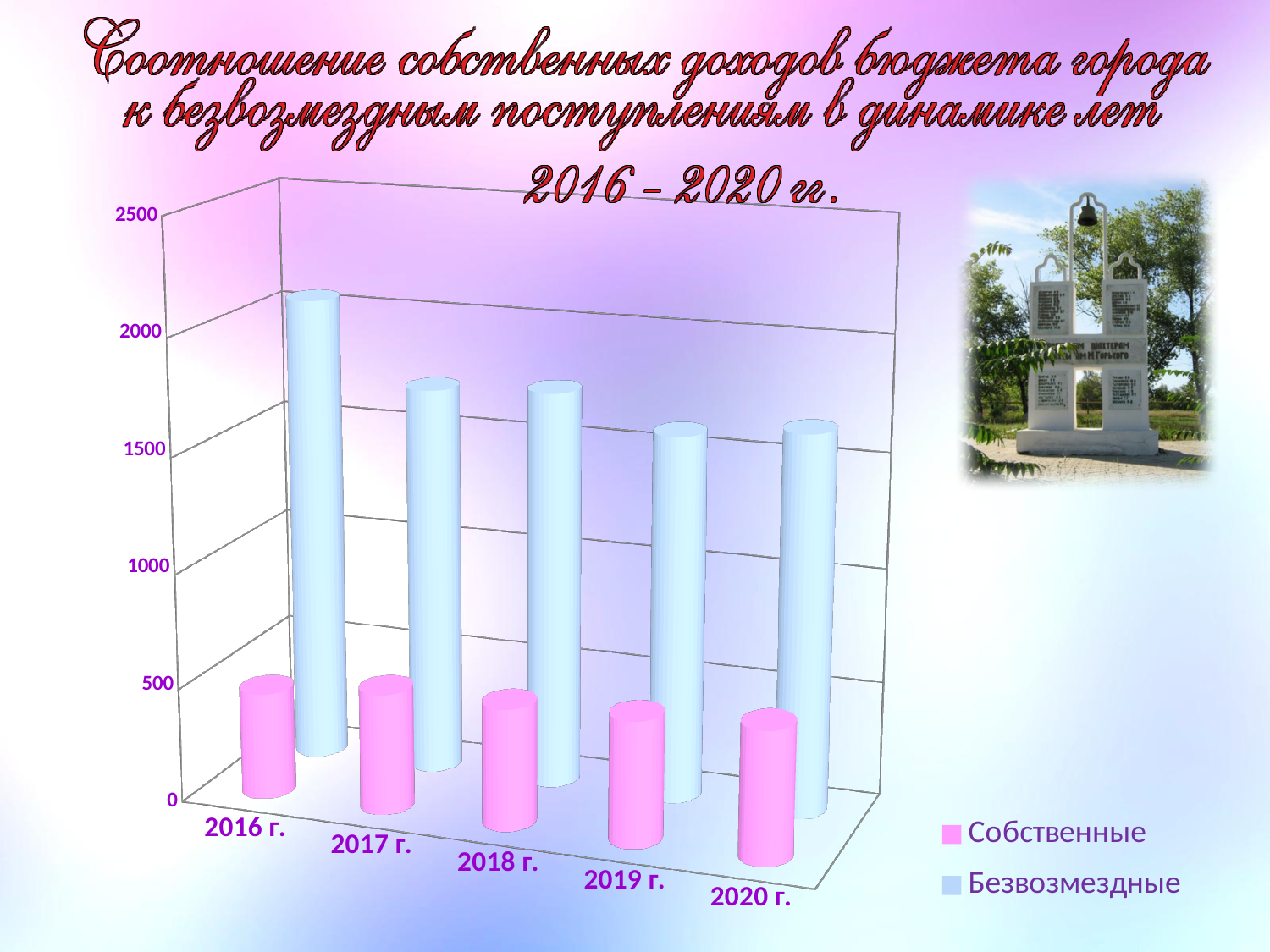
What kind of chart is shown on the slide? bar chart For Безвозмездные, which year has the larger value, 2016 г. or 2019 г.? 2016 г. Is the value for Собственные in 2019 г. greater or less than 1000? less Is the value for Безвозмездные in 2016 г. greater or less than 1500? greater What is the highest value shown on the vertical axis of the chart? 2500 In which year is the value for Безвозмездные the highest? 2016 г. Which colour represents the Собственные series in the chart? pink In 2016 г., which series has the larger value, Собственные or Безвозмездные? Безвозмездные How many series does the chart legend list? 2 How many years (categories) are shown on the x axis of the chart? 5 Is the value for Собственные in 2016 г. greater or less than 1000? less